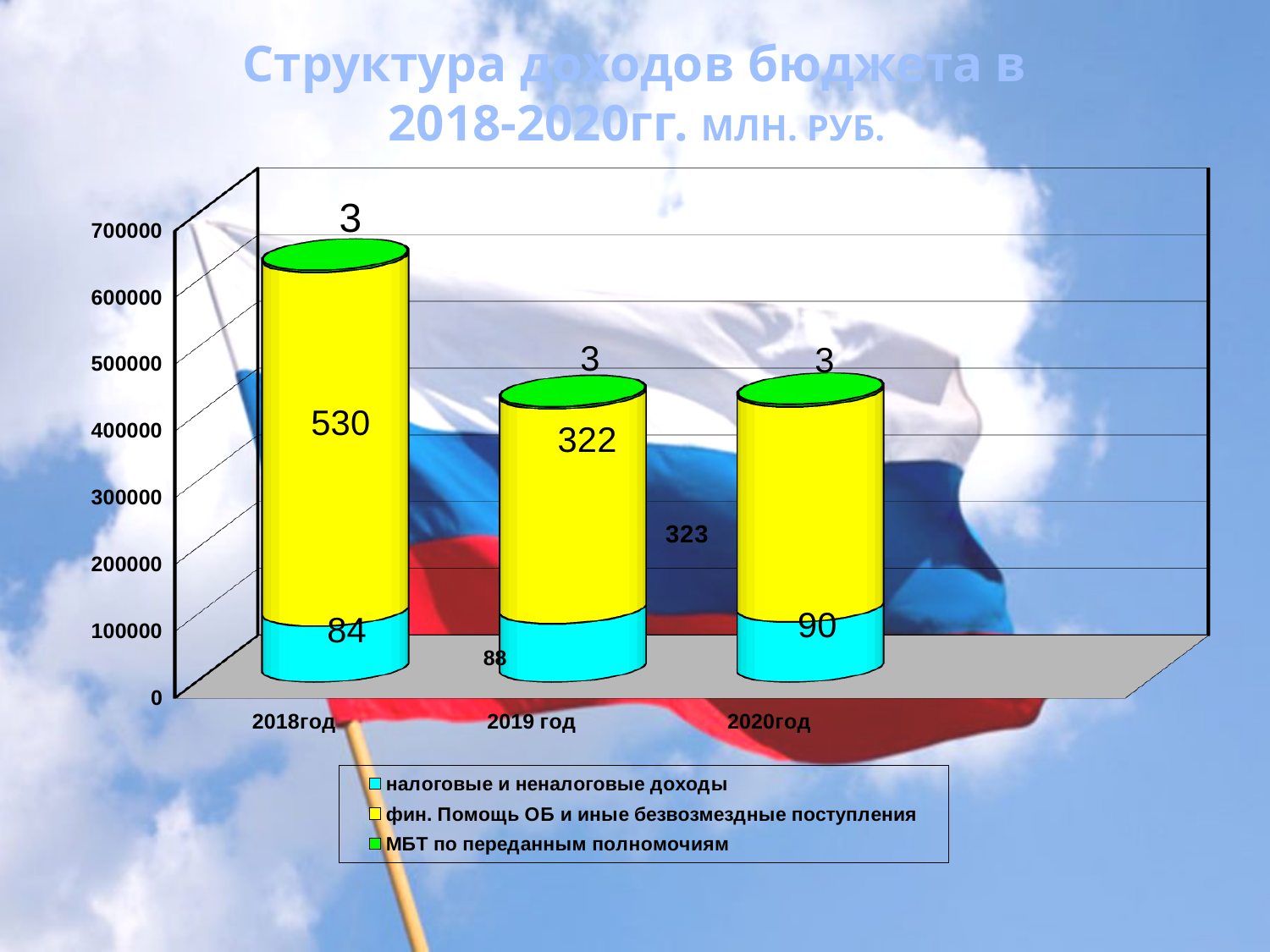
Do the values for налоговые и неналоговые доходы rise or fall from 2018год to 2020год? rise What is the value of фин. Помощь ОБ и иные безвозмездные поступления for 2019 год? 322 Which year has the highest value for фин. Помощь ОБ и иные безвозмездные поступления? 2018год What is the value of МБТ по переданным полномочиям for 2020год? 3 What is the difference between the фин. Помощь ОБ и иные безвозмездные поступления values for 2018год and 2019 год? 208 How many series does the legend list? 3 How many years are shown on the x axis? 3 What is the total of the stacked bar for 2018год? 617 What is the value of налоговые и неналоговые доходы for 2018год? 84 What is the value of налоговые и неналоговые доходы for 2020год? 90 Which year has the lowest value for налоговые и неналоговые доходы? 2018год Which is larger: налоговые и неналоговые доходы in 2019 год or in 2020год? 2020год